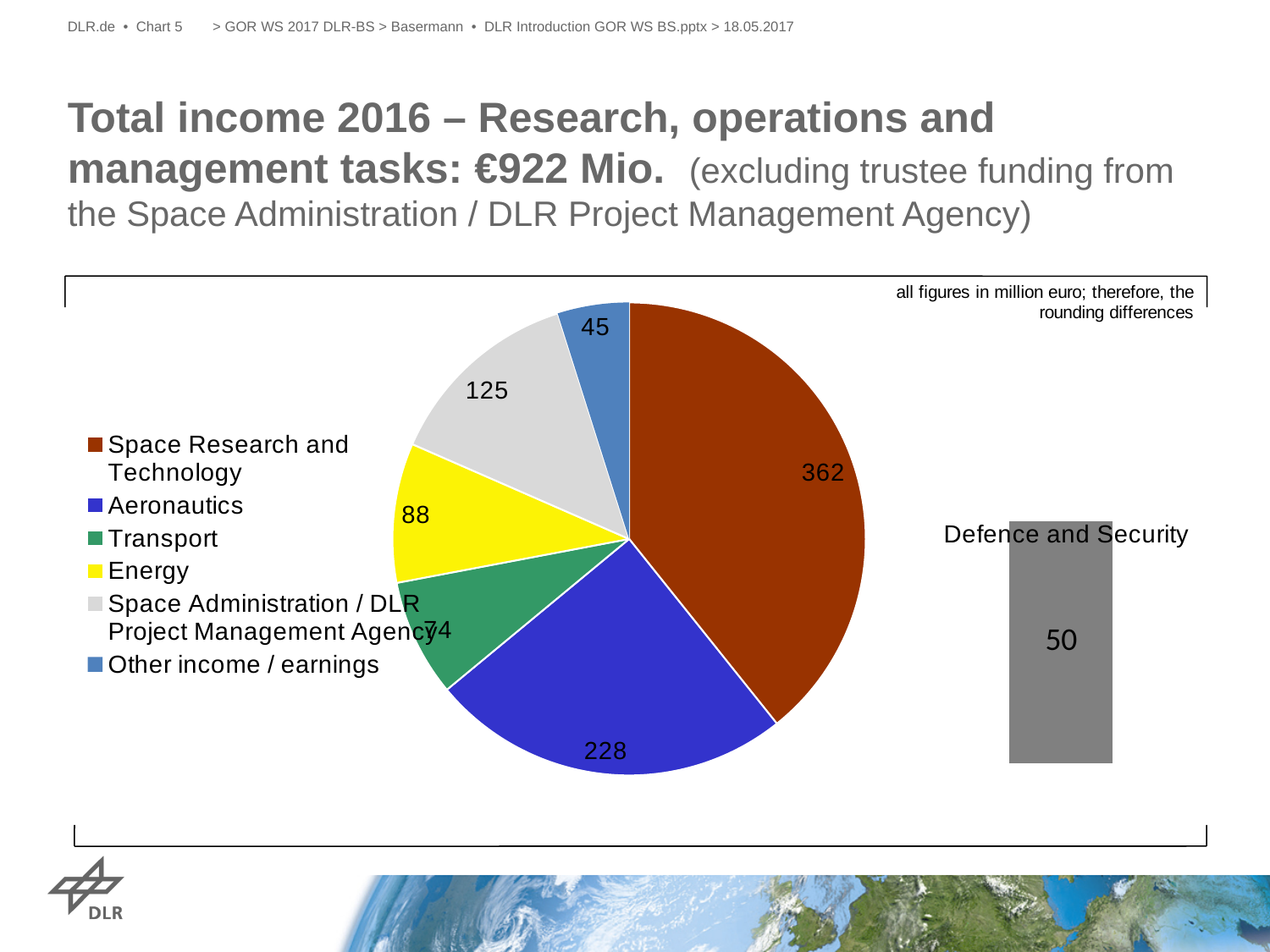
In the pie chart, what is the difference between the values for Space Research and Technology and Aeronautics? 134 In the pie chart, which category has the smallest slice? Other income / earnings In the pie chart, which is larger, Energy or Transport? Energy What kind of chart is the main chart on the slide? Pie chart In the pie chart, what is the value for Space Administration / DLR Project Management Agency? 125 How many slices does the pie chart have? 6 In the pie chart, which category has the largest slice? Space Research and Technology In the bar to the right of the pie chart, what is the value for Defence and Security? 50 In the pie chart, what is the value for Space Research and Technology? 362 In the pie chart, what is the value for Aeronautics? 228 In the pie chart, what is the value for Energy? 88 In the pie chart, what is the value for Other income / earnings? 45